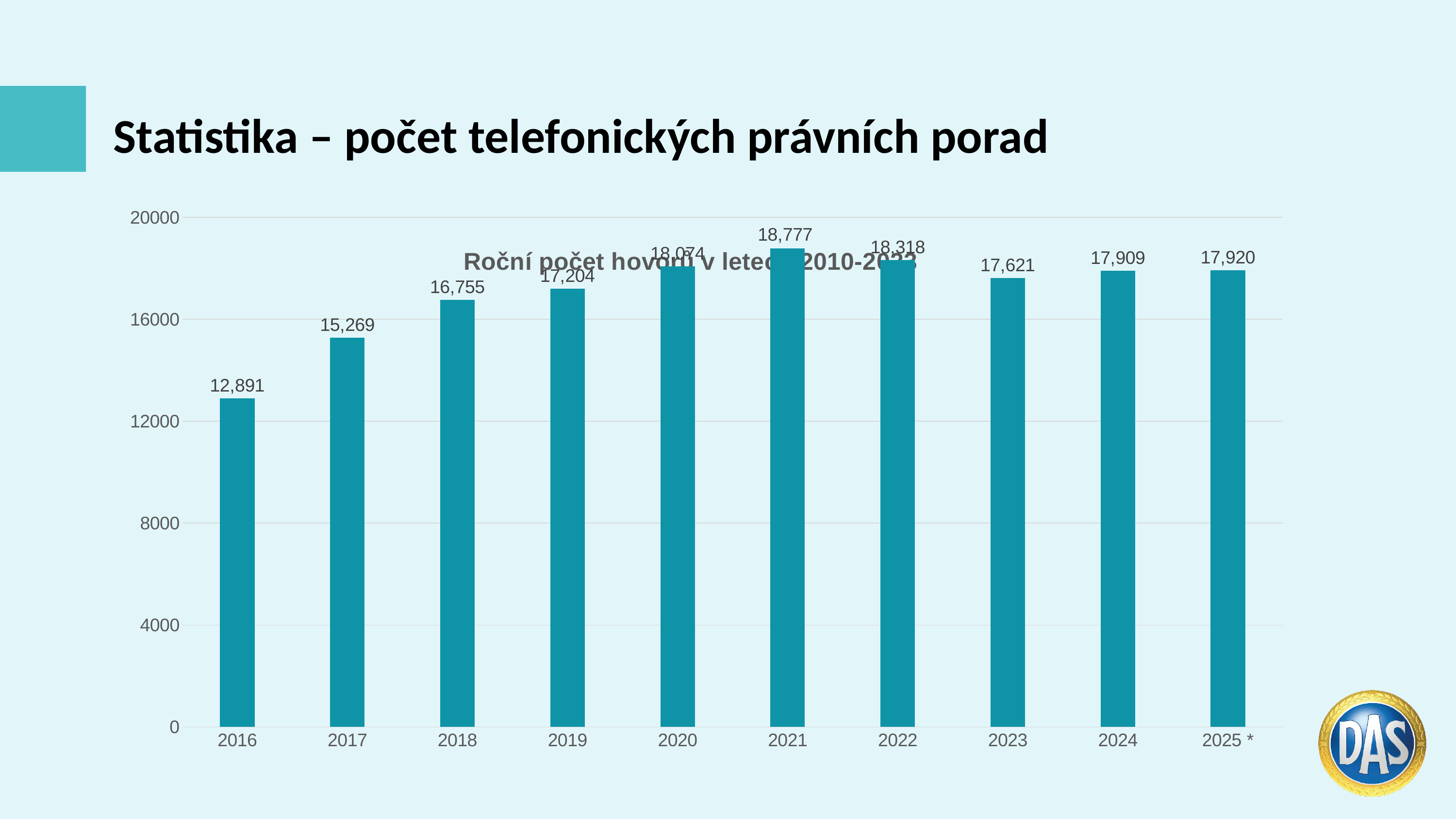
What is the value for 2021? 18,777 Is the value for 2016 greater or less than 16000? less What kind of chart is shown on the slide? bar chart Do the values rise or fall from 2016 to 2021? rise Which year has the lowest value? 2016 How many years are shown on the x axis? 10 Which is larger, the value for 2017 or the value for 2019? 2019 What is the value for 2025 *? 17,920 What is the value for 2016? 12,891 What is the difference between the values for 2017 and 2016? 2,378 Which year has the highest value? 2021 What is the difference between the values for 2021 and 2016? 5,886